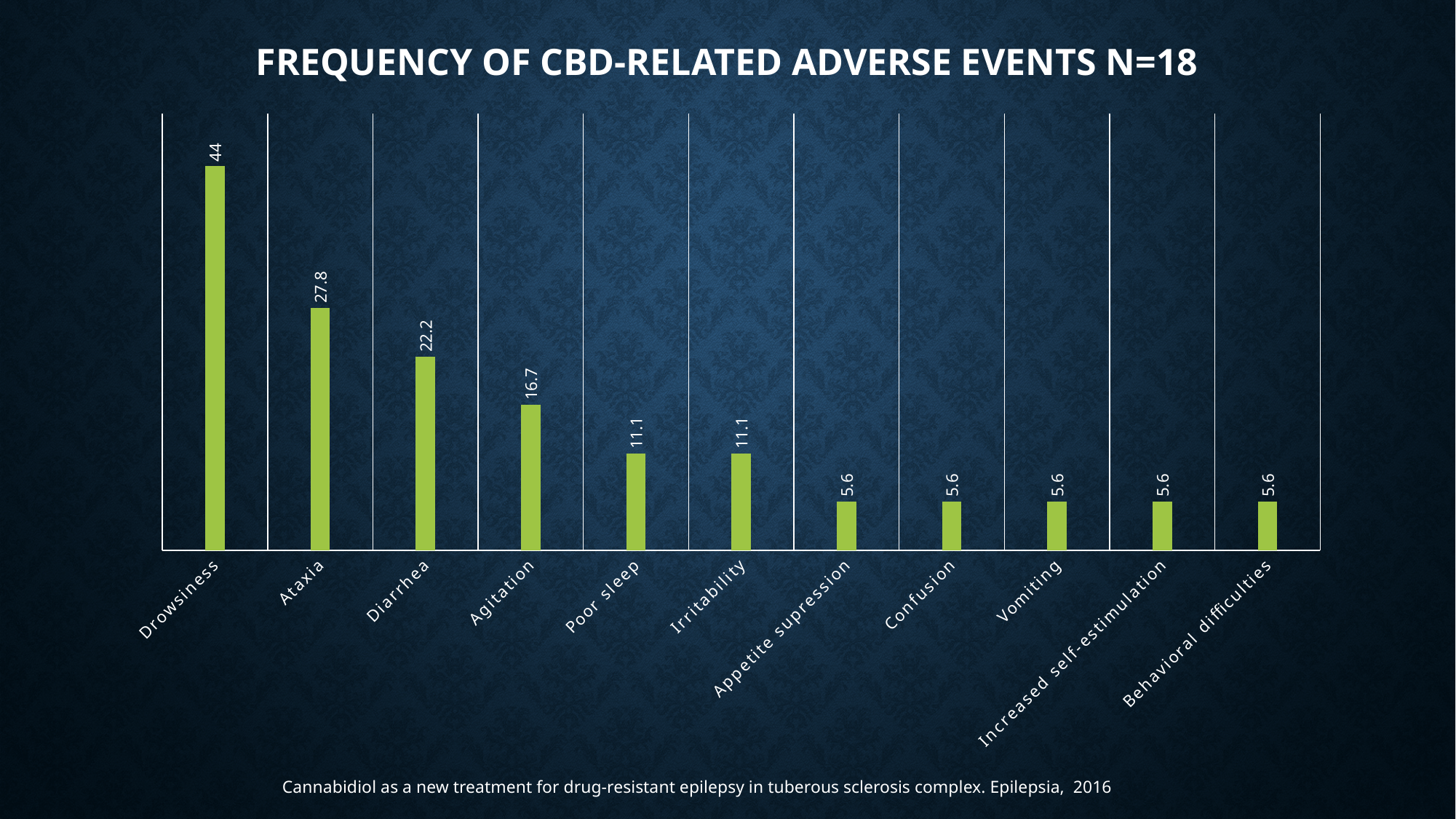
Which is larger, the value for Diarrhea or the value for Poor sleep? Diarrhea What is the difference between the values for Drowsiness and Ataxia? 16.2 Do the values rise or fall from left to right across the categories? Fall What is the value for Agitation? 16.7 What is the value for Ataxia? 27.8 Which adverse event has the highest frequency? Drowsiness How many adverse event categories are shown on the chart? 11 What is the value for Confusion? 5.6 What is the difference between the values for Diarrhea and Agitation? 5.5 What is the title of the chart? Frequency of CBD-related adverse events N=18 What is the value for Drowsiness? 44 What kind of chart is shown on the slide? Bar chart